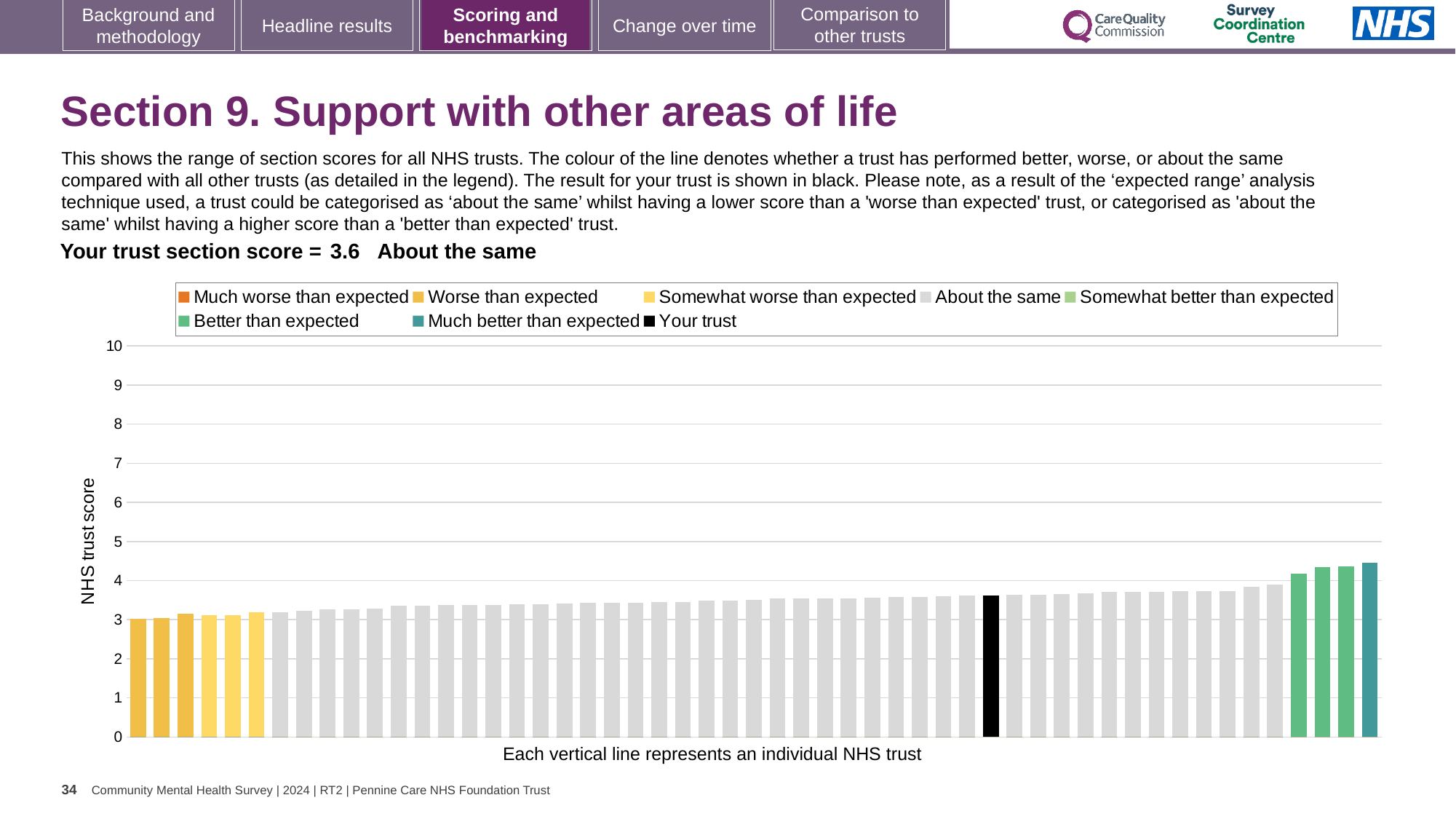
Is the value for your trust (the black bar) greater or less than 3? greater What type of chart is shown on the slide? Bar chart What is the section score for your trust shown on the slide? 3.6 What is the label on the vertical axis of the chart? NHS trust score Do the bar values rise or fall from left to right along the x axis? Rise Is the value of the shortest bar greater or less than 2? greater Which legend category do the shortest bars belong to? Worse than expected Is the value for your trust (the black bar) greater or less than 4? less What performance category is given for your trust's section score? About the same Which legend category does the tallest bar belong to? Much better than expected How many entries does the chart legend list? 8